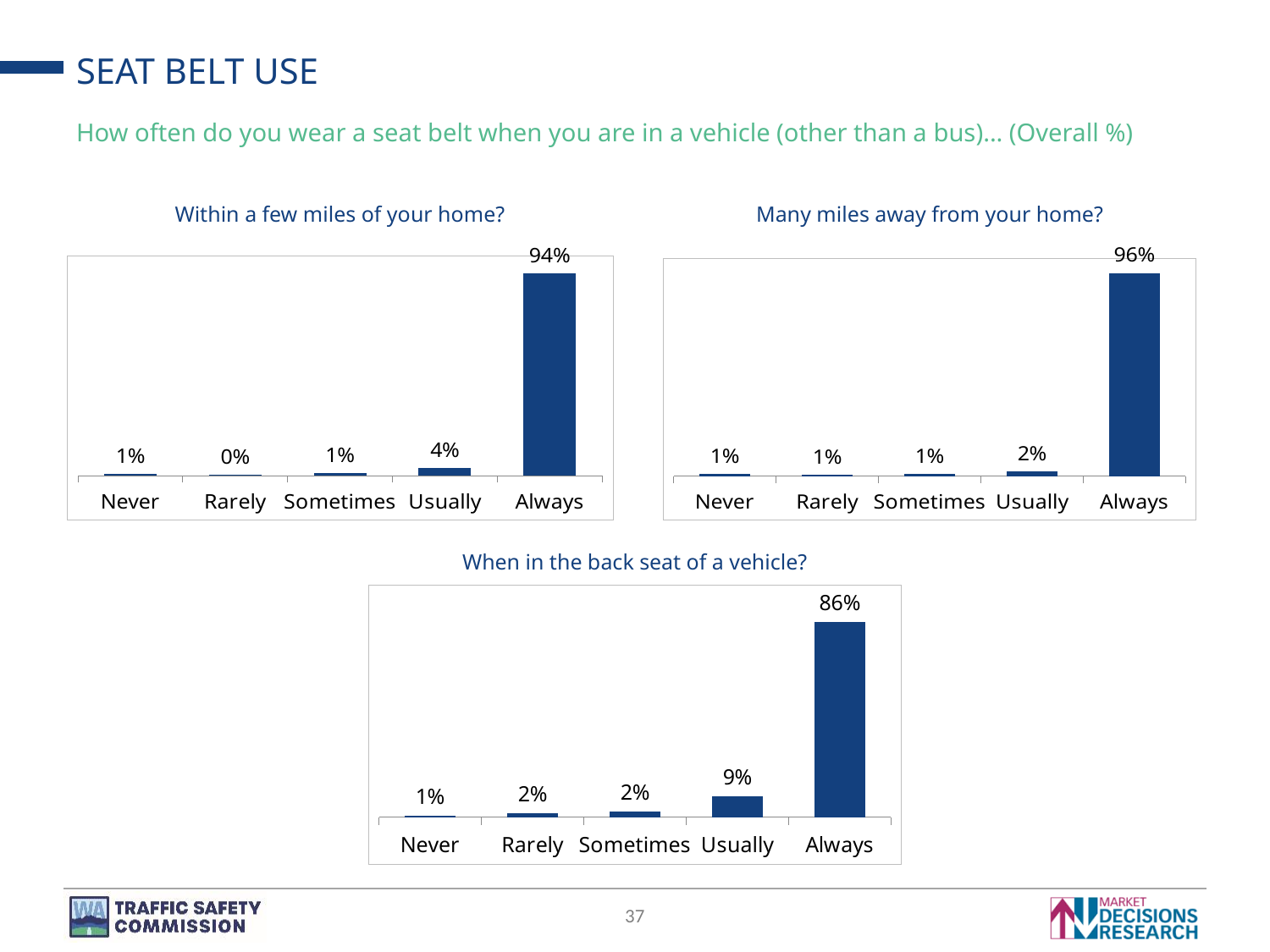
In the 'Within a few miles of your home?' chart, what is the value for Always? 94% In the 'Within a few miles of your home?' chart, which category has the lowest value? Rarely How many charts are on the slide? 3 In the 'When in the back seat of a vehicle?' chart, which category has the highest value? Always In the 'When in the back seat of a vehicle?' chart, what is the difference between the Usually and Sometimes values? 7% In the 'Many miles away from your home?' chart, what is the value for Usually? 2% How many categories are shown in the 'When in the back seat of a vehicle?' chart? 5 Which is larger: the Always value in the 'Within a few miles of your home?' chart or the Always value in the 'Many miles away from your home?' chart? Many miles away from your home? In the 'When in the back seat of a vehicle?' chart, what is the value for Usually? 9% What is the difference between the Always value in the 'Many miles away from your home?' chart and the Always value in the 'When in the back seat of a vehicle?' chart? 10% What kind of chart is the 'Many miles away from your home?' chart? Bar chart In the 'Within a few miles of your home?' chart, what is the value for Usually? 4%